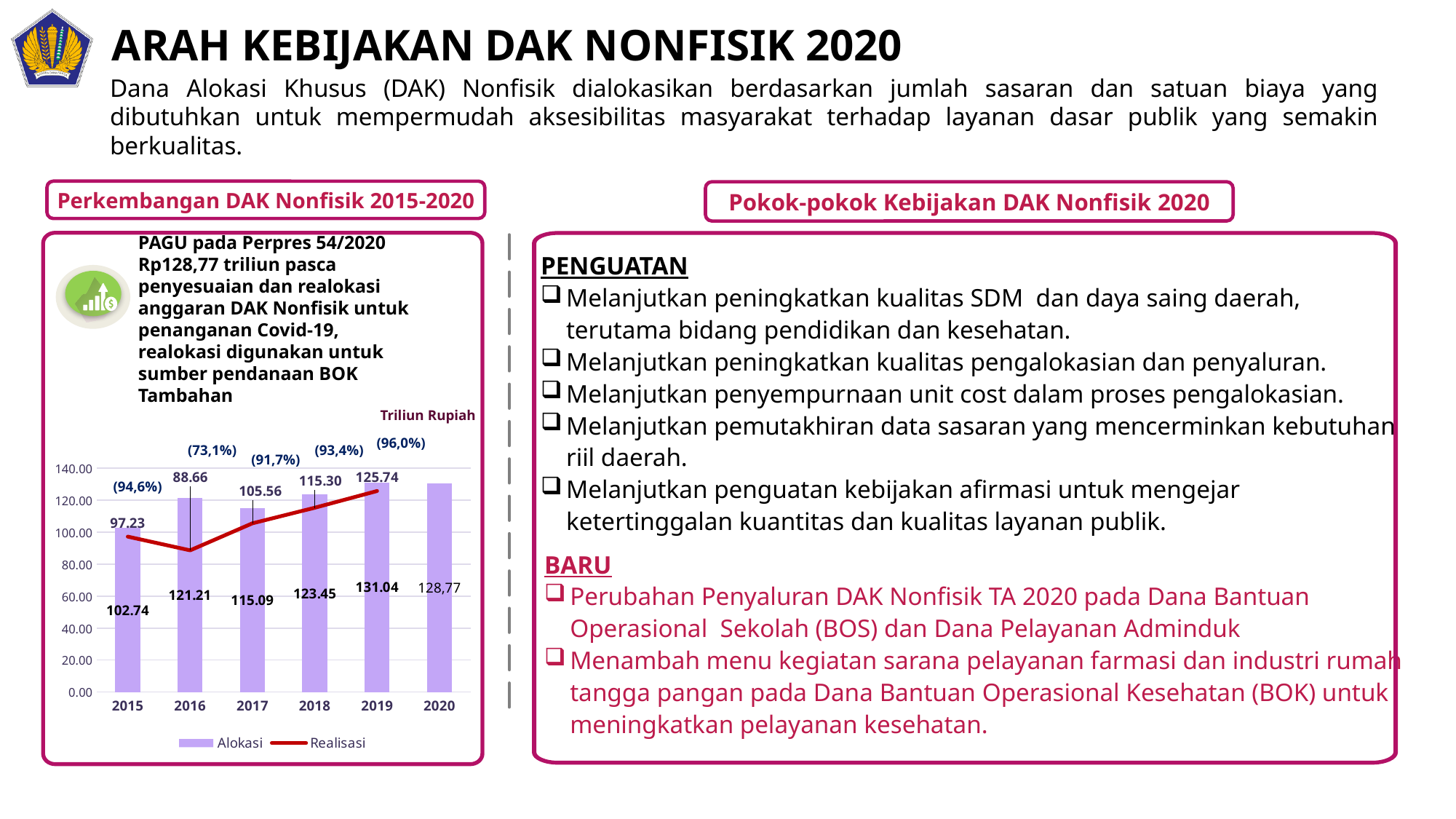
What is the Alokasi value for 2020? 128,77 Which is larger, the Realisasi value for 2015 or the Realisasi value for 2016? 2015 How many years are shown on the x axis of the chart? 6 What is the Alokasi value for 2019? 131.04 Which year has the lowest Realisasi value? 2016 Which year has the highest Alokasi value? 2019 What kind of chart is used to show the Alokasi series? Bar chart What is the difference between the Alokasi and Realisasi values for 2017? 9.53 What is the Realisasi value for 2018? 115.30 What is the Realisasi value for 2016? 88.66 What unit is stated above the chart? Triliun Rupiah How many series does the chart legend list? 2